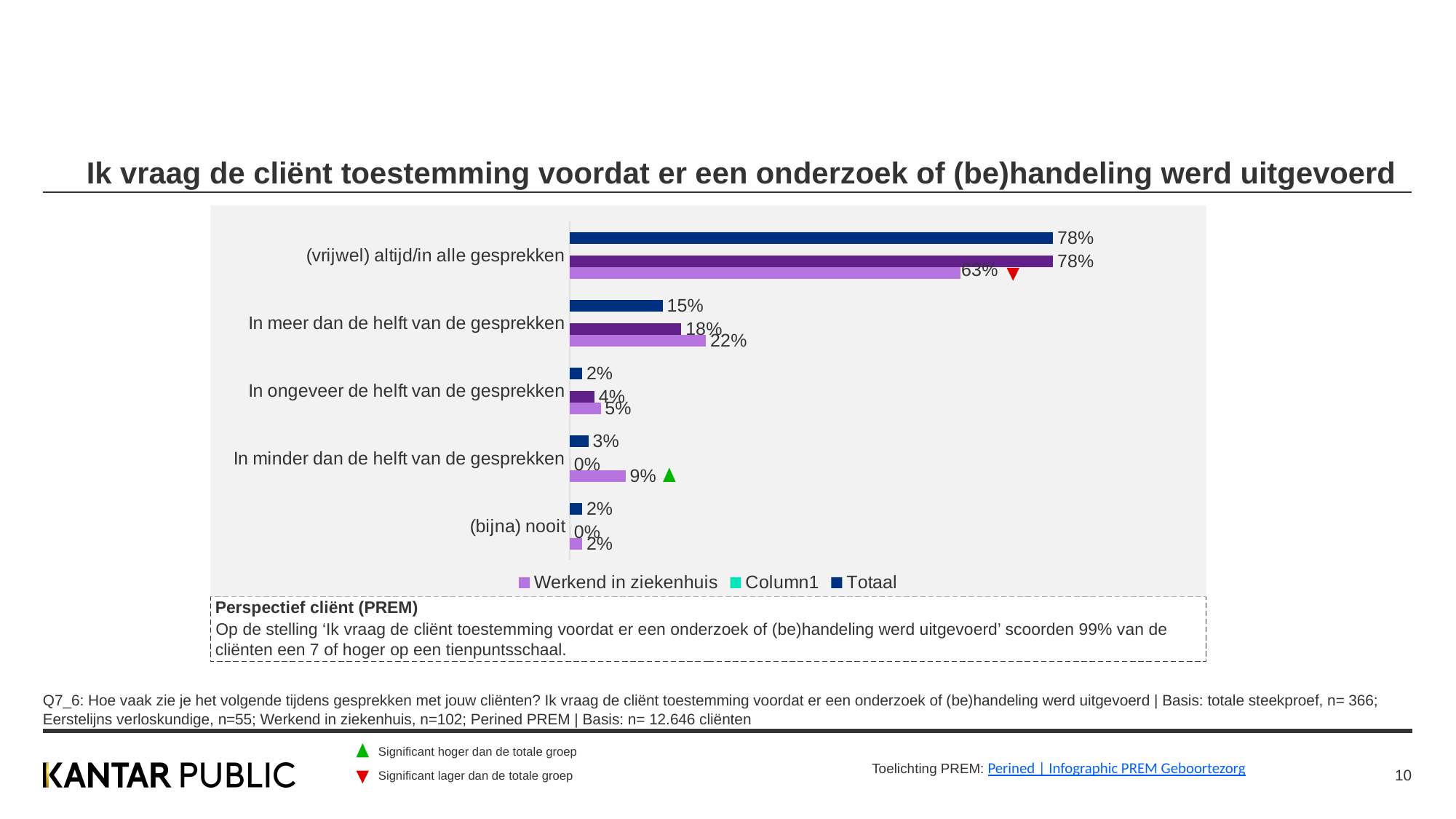
What is the difference between the 'Werkend in ziekenhuis' value and the Totaal value for 'In minder dan de helft van de gesprekken'? 6% What is the Totaal value for 'In minder dan de helft van de gesprekken'? 3% How many series does the legend list? 3 How many categories are shown on the chart? 5 Which category has the highest Totaal value? (vrijwel) altijd/in alle gesprekken What is the difference between the Totaal value and the 'Werkend in ziekenhuis' value for '(vrijwel) altijd/in alle gesprekken'? 15% What is the Totaal value for '(vrijwel) altijd/in alle gesprekken'? 78% What is the 'Werkend in ziekenhuis' value for 'In meer dan de helft van de gesprekken'? 22% For 'In meer dan de helft van de gesprekken', which is larger: the Totaal value or the 'Werkend in ziekenhuis' value? Werkend in ziekenhuis What is the 'Werkend in ziekenhuis' value for '(vrijwel) altijd/in alle gesprekken'? 63% Which category has the highest 'Werkend in ziekenhuis' value? (vrijwel) altijd/in alle gesprekken What kind of chart is shown on the slide? Bar chart